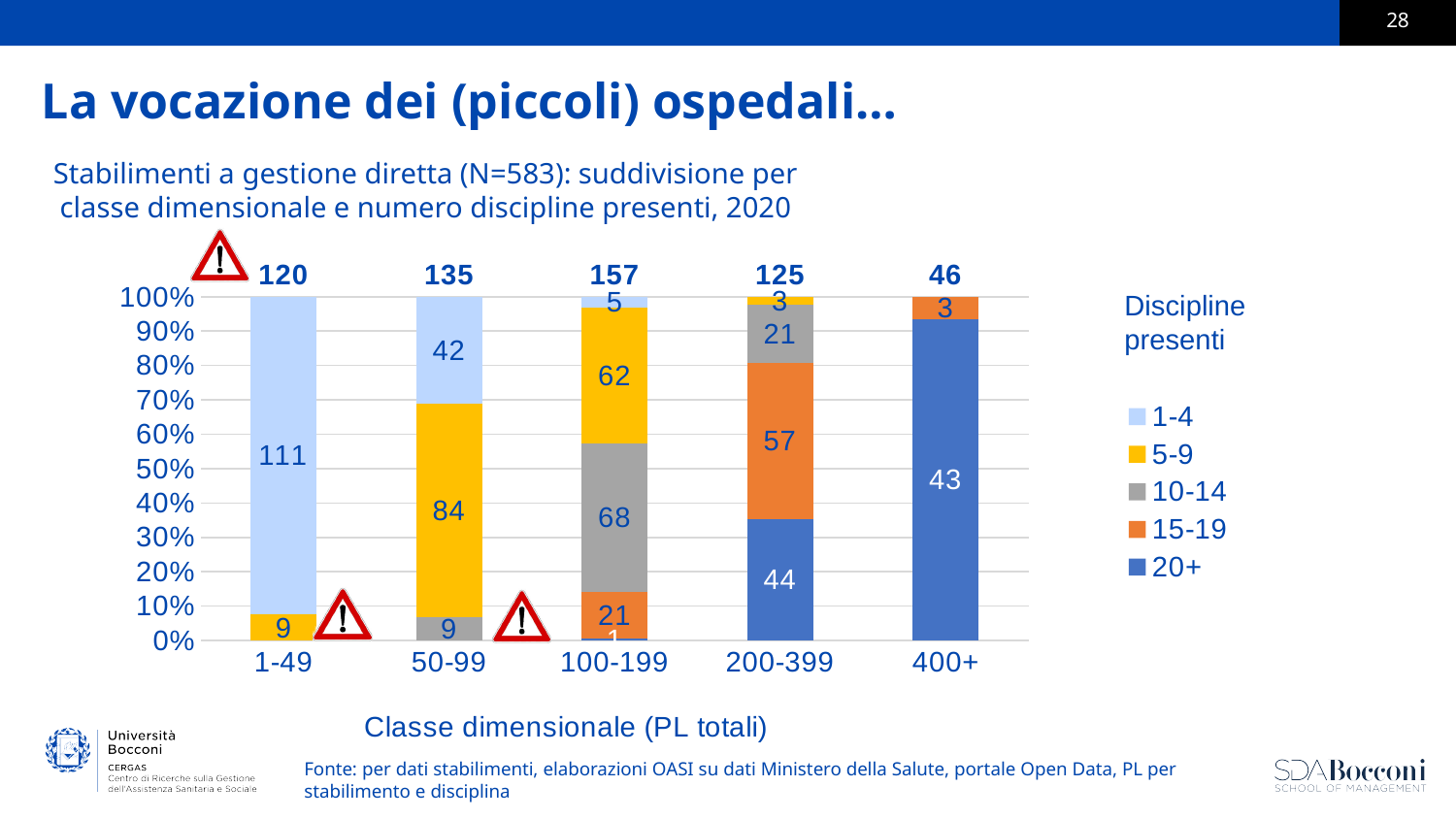
What type of chart is shown on the slide? stacked bar chart What is the value of the '15-19' segment in the 200-399 class? 57 What is the value of the '5-9' segment in the 50-99 class? 84 Which size class has the lowest total number of establishments? 400+ What is the value of the '1-4' segment in the 1-49 class? 111 How many size classes (categories) are shown on the x axis? 5 What is the total number of establishments shown above the bar for the 100-199 class? 157 What is the difference between the totals of the 50-99 class and the 1-49 class? 15 How many series does the legend 'Discipline presenti' list? 5 Which is larger in the 100-199 class: the '10-14' segment or the '5-9' segment? 10-14 What is the value of the '20+' segment in the 400+ class? 43 Which size class has the highest total number of establishments? 100-199